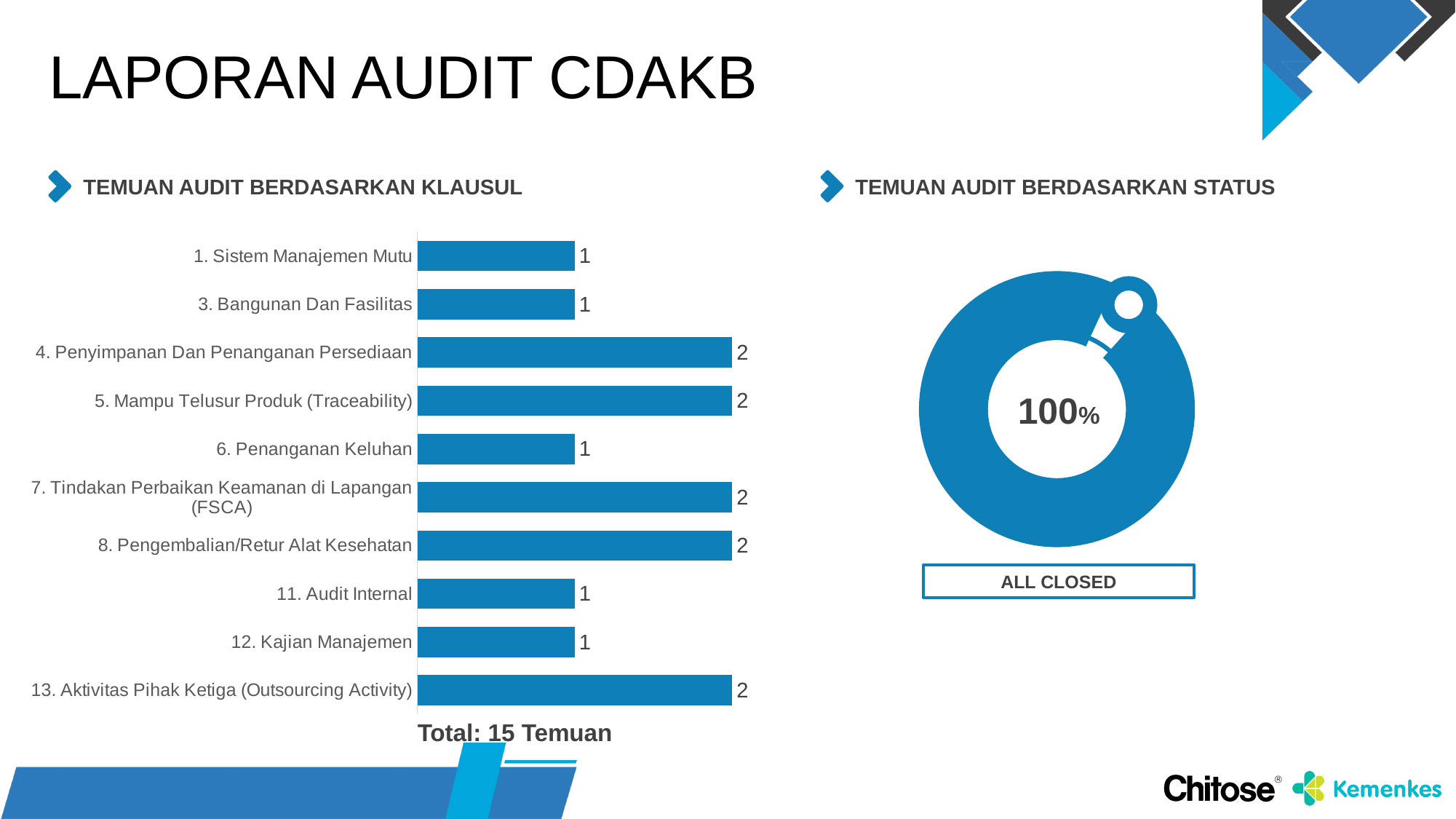
In the 'TEMUAN AUDIT BERDASARKAN KLAUSUL' chart, how many categories are shown? 10 In the 'TEMUAN AUDIT BERDASARKAN KLAUSUL' chart, how many categories have a value of 2? 5 What status label is shown below the 'TEMUAN AUDIT BERDASARKAN STATUS' donut chart? ALL CLOSED In the 'TEMUAN AUDIT BERDASARKAN KLAUSUL' chart, what is the difference between '8. Pengembalian/Retur Alat Kesehatan' and '3. Bangunan Dan Fasilitas'? 1 What kind of chart is the 'TEMUAN AUDIT BERDASARKAN KLAUSUL' chart? Bar chart In the 'TEMUAN AUDIT BERDASARKAN KLAUSUL' chart, what is the value for '4. Penyimpanan Dan Penanganan Persediaan'? 2 In the 'TEMUAN AUDIT BERDASARKAN KLAUSUL' chart, which is larger: '5. Mampu Telusur Produk (Traceability)' or '12. Kajian Manajemen'? 5. Mampu Telusur Produk (Traceability) What total is stated below the 'TEMUAN AUDIT BERDASARKAN KLAUSUL' chart? Total: 15 Temuan In the 'TEMUAN AUDIT BERDASARKAN KLAUSUL' chart, what is the value for '13. Aktivitas Pihak Ketiga (Outsourcing Activity)'? 2 In the 'TEMUAN AUDIT BERDASARKAN KLAUSUL' chart, what is the value for '6. Penanganan Keluhan'? 1 In the 'TEMUAN AUDIT BERDASARKAN KLAUSUL' chart, what is the value for '11. Audit Internal'? 1 In the 'TEMUAN AUDIT BERDASARKAN STATUS' chart, what percentage is shown in the centre of the donut? 100%